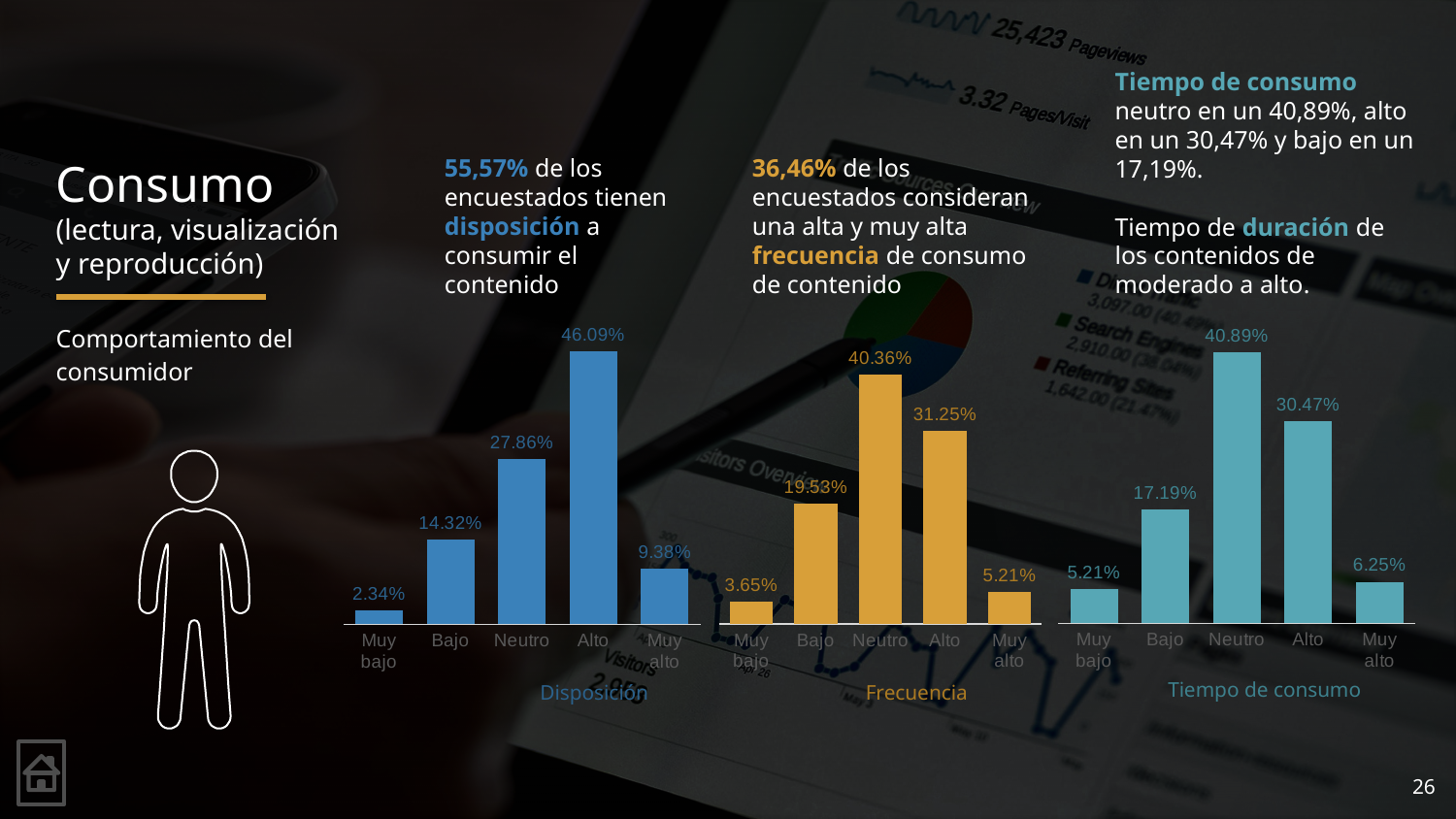
In the Tiempo de consumo chart, which category has the highest value? Neutro What kind of chart is the Frecuencia chart? Bar chart In the Disposición chart, which category has the lowest value? Muy bajo What colour are the bars in the Tiempo de consumo chart? Teal In the Frecuencia chart, which category has the highest value? Neutro In the Disposición chart, what is the difference between the values for Alto and Neutro? 18.23% In the Tiempo de consumo chart, what is the value for Bajo? 17.19% In the Tiempo de consumo chart, what is the difference between the values for Neutro and Alto? 10.42% In the Disposición chart, what is the value for Alto? 46.09% How many categories are shown in the Disposición chart? 5 In the Frecuencia chart, what is the value for Neutro? 40.36% In the Frecuencia chart, which is larger, the value for Bajo or the value for Alto? Alto